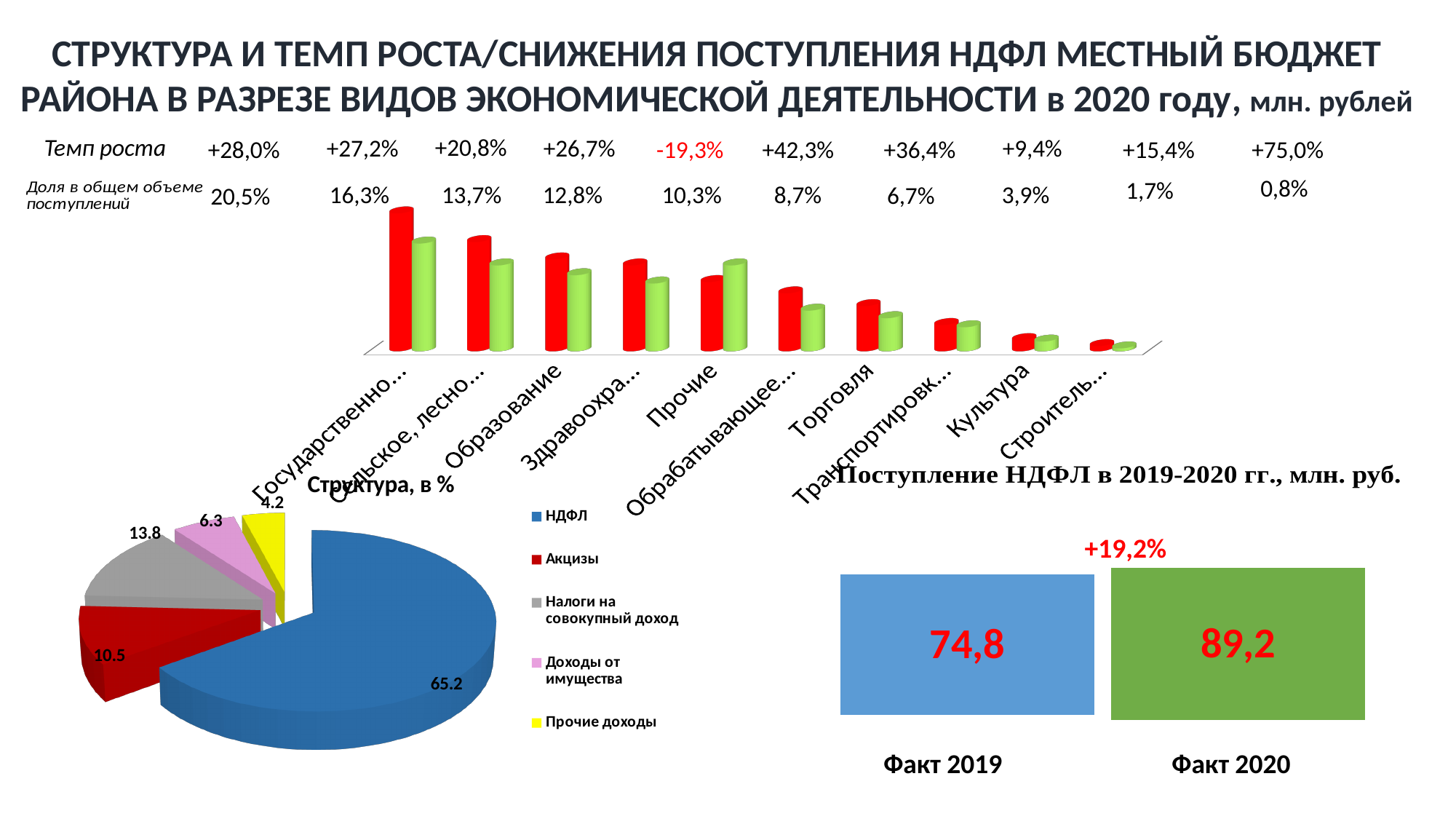
In the top bar chart, what growth rate (Темп роста) is shown for Прочие? -19,3% In the chart 'Поступление НДФЛ в 2019-2020 гг., млн. руб.', what is the value for Факт 2019? 74,8 In the pie chart 'Структура, в %', how many categories does the legend list? 5 In the pie chart 'Структура, в %', which category has the smallest slice? Прочие доходы In the pie chart 'Структура, в %', which is larger: Акцизы or Доходы от имущества? Акцизы In the pie chart 'Структура, в %', what is the share for НДФЛ? 65.2 In the chart 'Поступление НДФЛ в 2019-2020 гг., млн. руб.', what is the value for Факт 2020? 89,2 In the top bar chart, how many categories are shown on the x axis? 10 What kind of chart is 'Структура, в %'? pie chart In the pie chart 'Структура, в %', what is the value for Налоги на совокупный доход? 13.8 In the chart 'Поступление НДФЛ в 2019-2020 гг., млн. руб.', what is the difference between Факт 2020 and Факт 2019? 14,4 In the chart 'Поступление НДФЛ в 2019-2020 гг., млн. руб.', what percentage change is shown above the 2020 bar? +19,2%